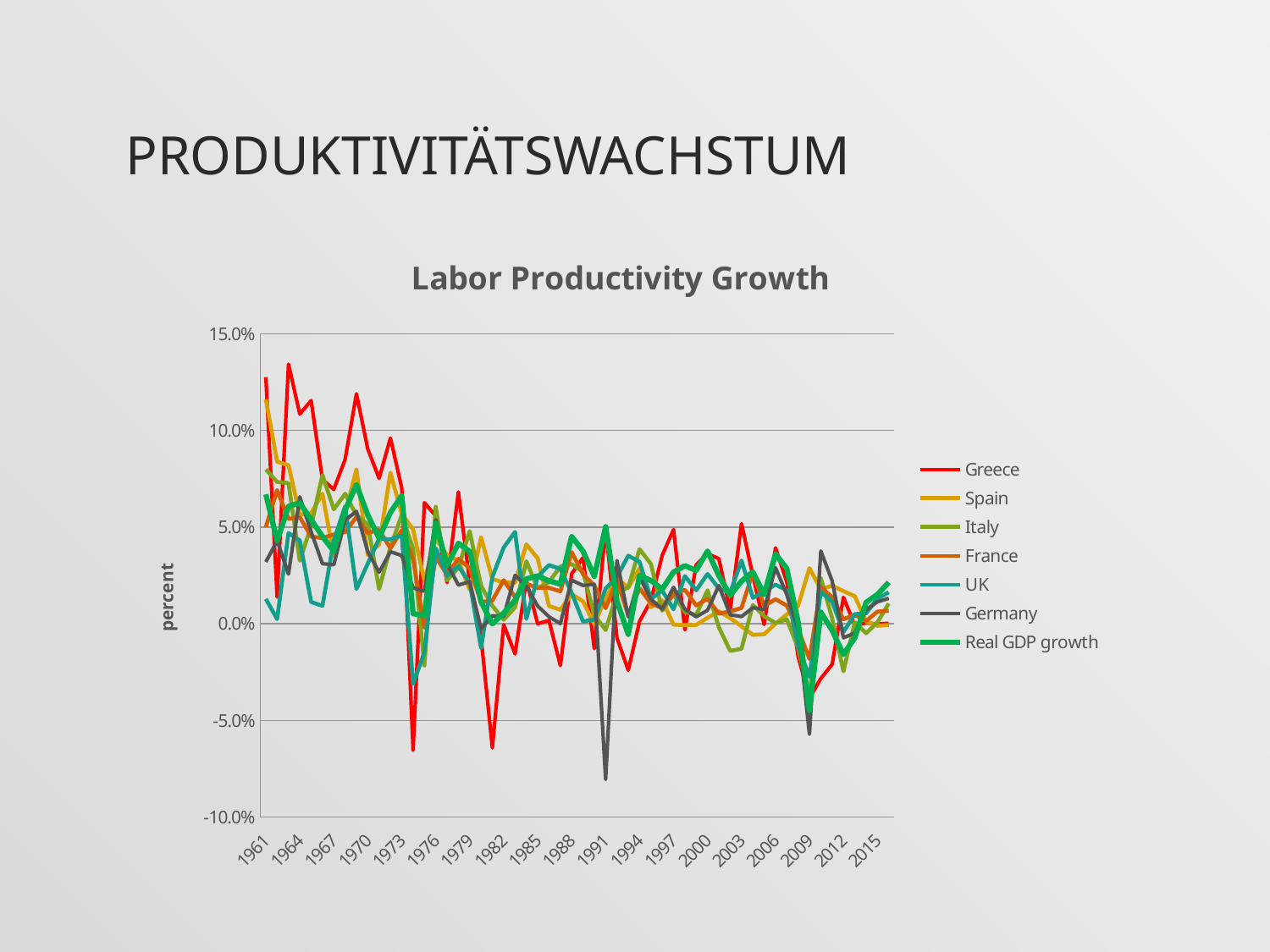
What is the title of the chart? Labor Productivity Growth Is the value for Germany in 1991 greater or less than -5.0%? less Is the value for Greece in 1974 greater or less than -5.0%? less Overall, do the values for Greece rise or fall from 1961 to 2015? fall In 1961, which is larger: the value for Greece or the value for Germany? Greece Which series has the highest value in 1963? Greece What kind of chart is shown on the slide? line chart Is the value for Greece in 1961 greater or less than 10.0%? greater How many year labels are shown on the x axis? 19 How many series does the legend of the Labor Productivity Growth chart list? 7 Which series has the lowest value in 1991? Germany What is the label on the vertical axis of the chart? percent